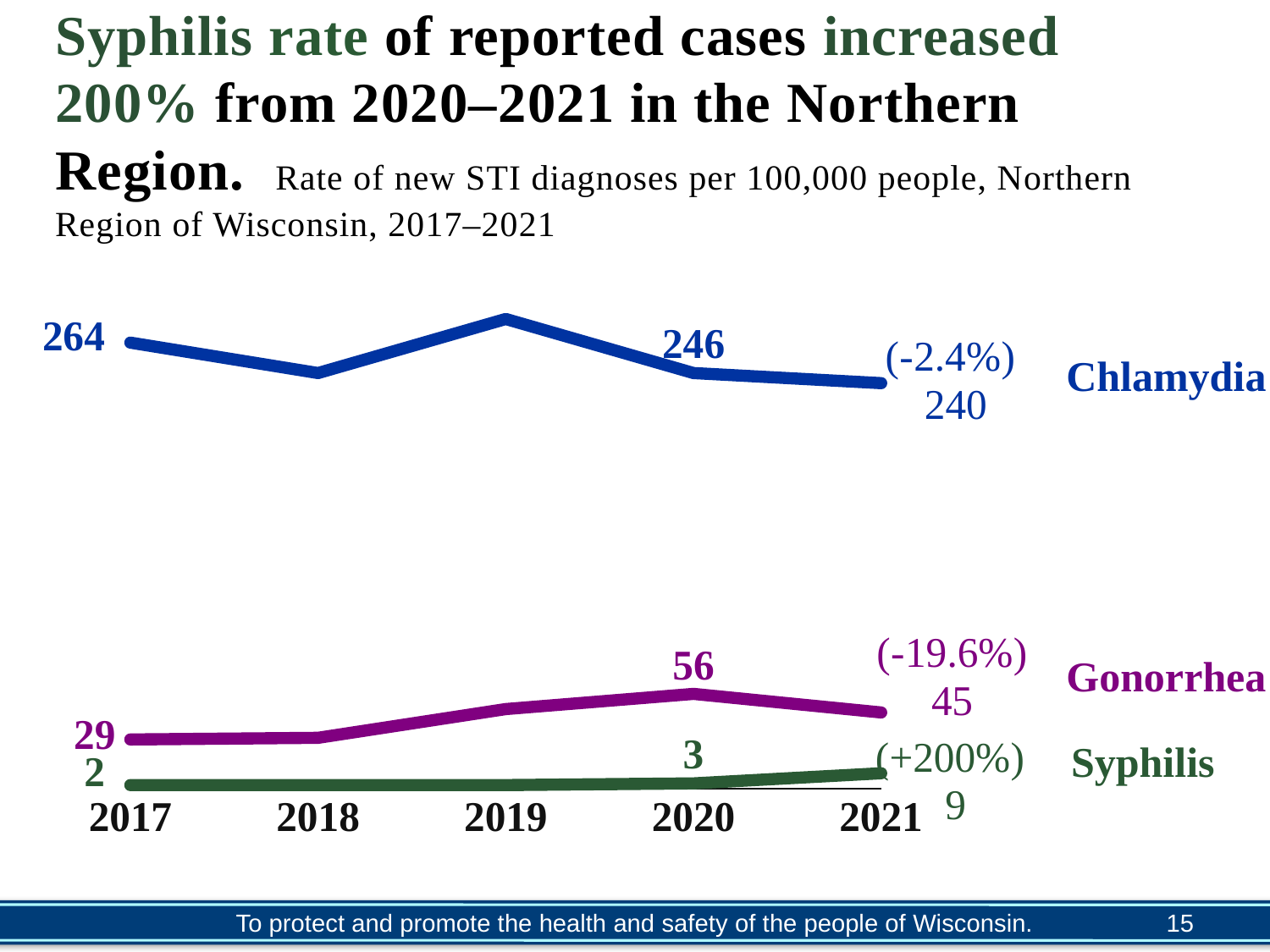
What type of chart is shown on the slide? Line chart What percentage change is shown for Gonorrhea from 2020 to 2021? -19.6% What was the Chlamydia rate in 2021? 240 How many years are shown on the x axis? 5 Did the Syphilis rate rise or fall from 2020 to 2021? Rise What was the Syphilis rate in 2021? 9 Which series had the lowest rate in 2017? Syphilis How many series are plotted on the chart? 3 What was the Gonorrhea rate in 2020? 56 By how much did the Gonorrhea rate change from 2020 to 2021? Decreased by 11 (from 56 to 45) Which series had the highest rate in 2021? Chlamydia What was the Chlamydia rate in 2017? 264